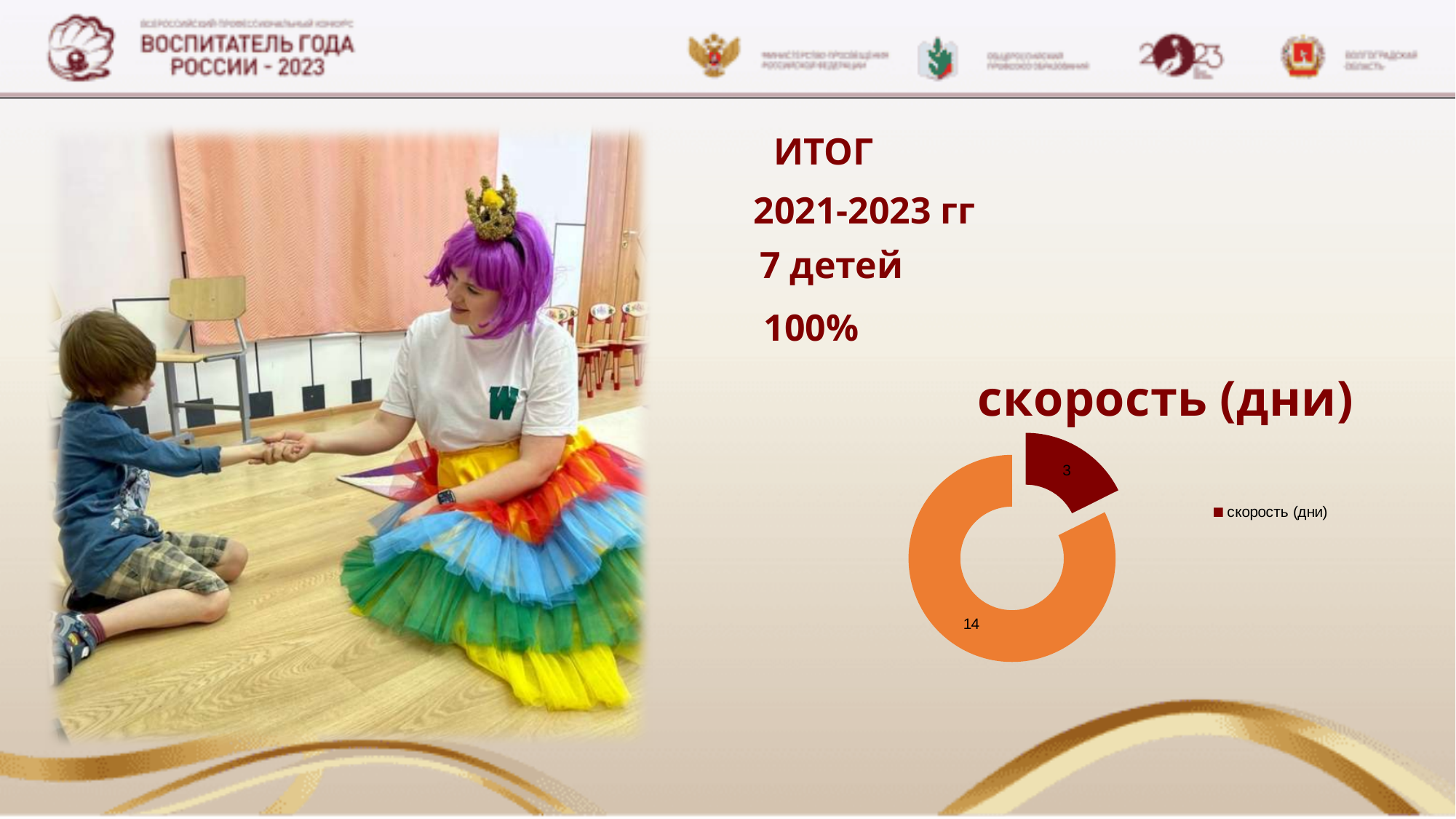
What is the total of the two values shown in the doughnut chart? 17 What is the largest value shown in the doughnut chart? 14 What is the value of the dark red slice in the doughnut chart? 3 What is the legend entry shown next to the doughnut chart? скорость (дни) What is the title of the chart on the slide? скорость (дни) How many slices does the doughnut chart have? 2 What kind of chart is shown on the slide? doughnut chart How many series does the chart legend list? 1 Which slice is larger, the orange one or the dark red one? the orange one What is the smallest value shown in the doughnut chart? 3 What is the difference between the two values in the doughnut chart? 11 What is the value of the orange slice in the doughnut chart? 14